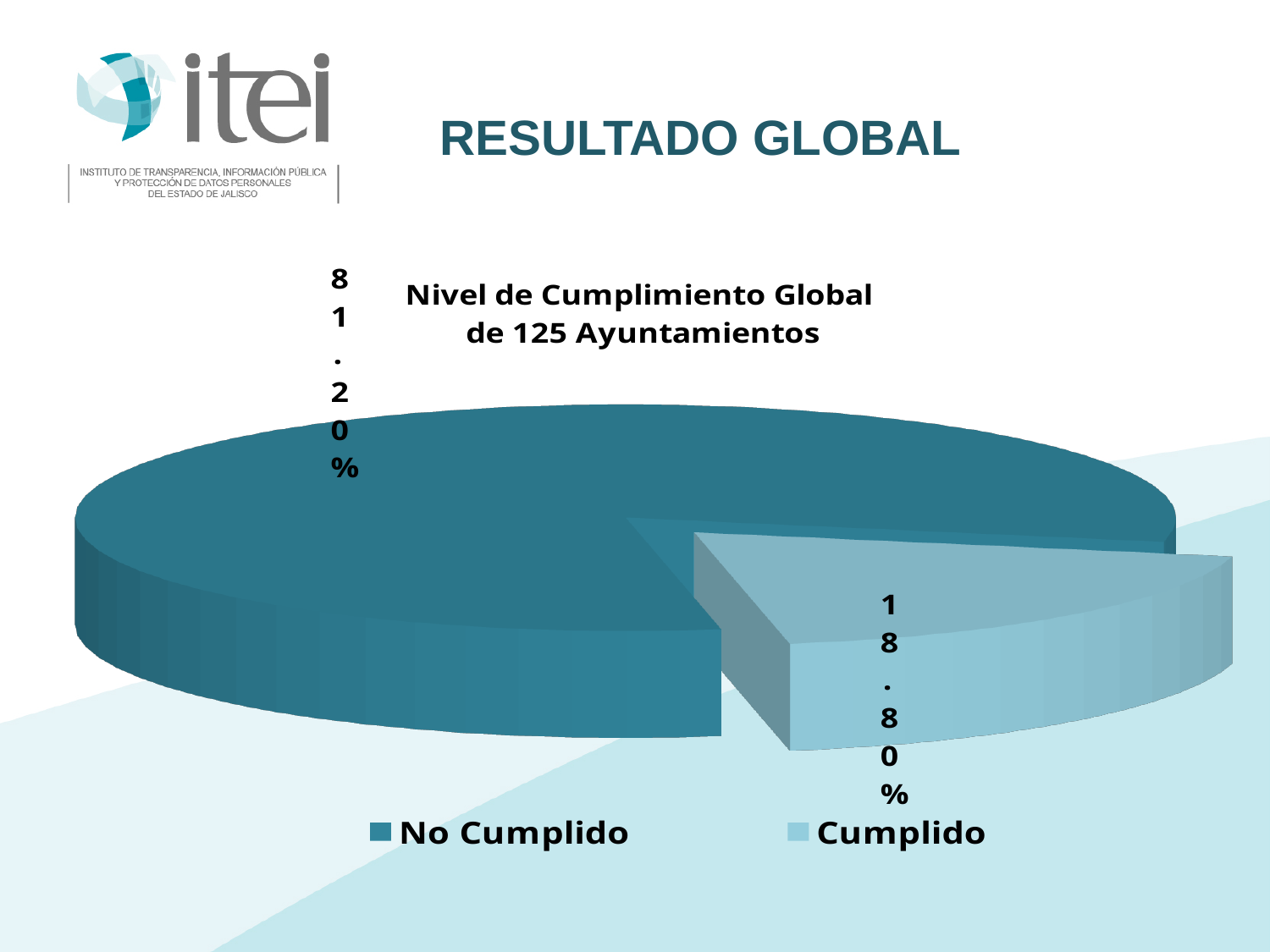
Which category has the largest share of the pie? No Cumplido What is the title of the chart? Nivel de Cumplimiento Global de 125 Ayuntamientos What percentage of the pie is labelled for No Cumplido? 81.20% What type of chart is shown on the slide? Pie chart What is the difference in percentage points between the No Cumplido and Cumplido slices? 62.40% Which category has the smallest share of the pie? Cumplido What are the two legend entries of the chart? No Cumplido and Cumplido What percentage of the pie is labelled for Cumplido? 18.80% Which is larger, the share for No Cumplido or the share for Cumplido? No Cumplido How many Ayuntamientos does the chart title say are covered? 125 How many slices does the pie chart have? 2 How many entries does the legend list? 2